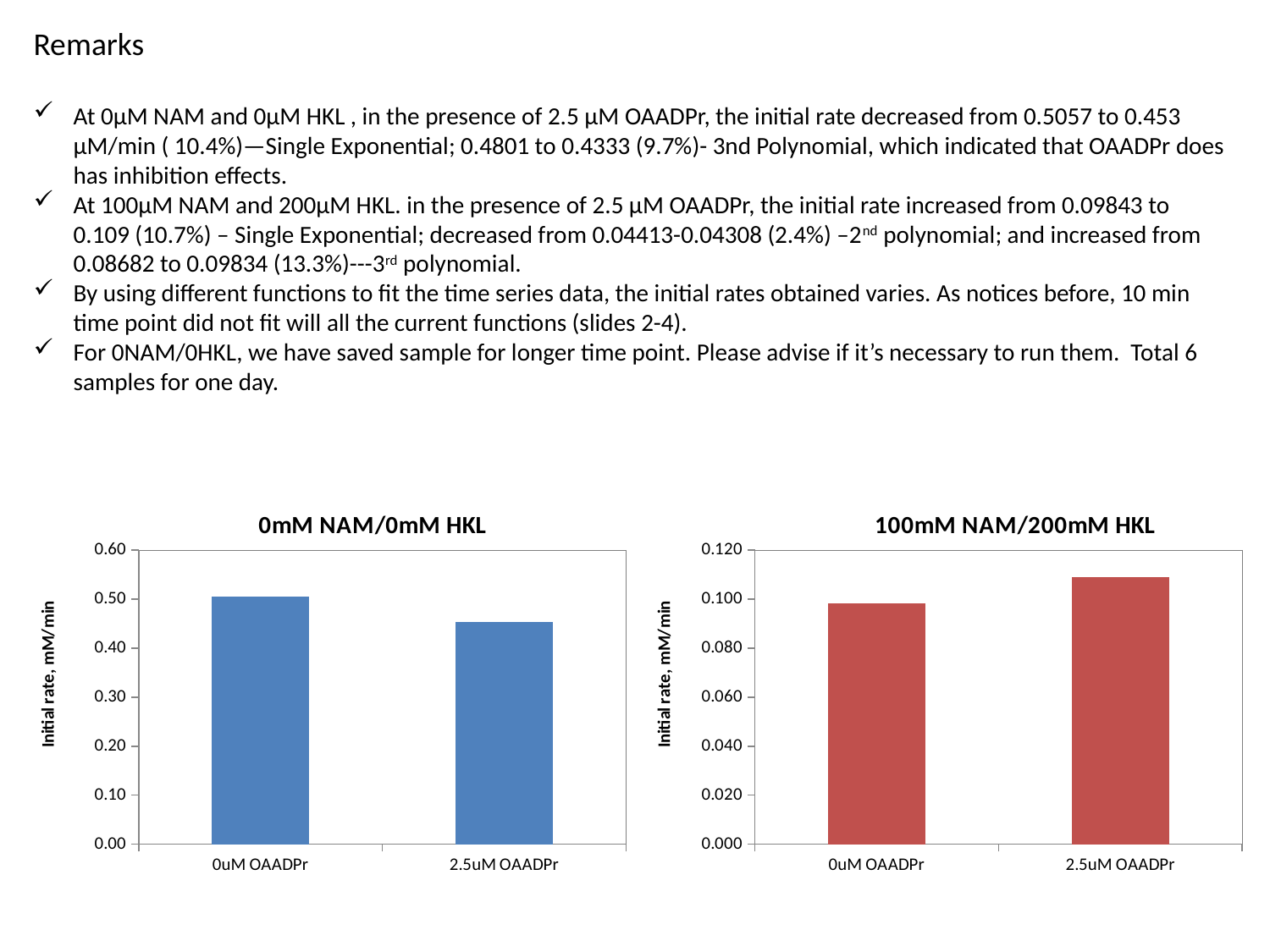
In the chart titled 0mM NAM/0mM HKL, is the value for 2.5uM OAADPr greater or less than 0.40? greater In the chart titled 100mM NAM/200mM HKL, is the value for 0uM OAADPr greater or less than 0.080? greater In the chart titled 100mM NAM/200mM HKL, which category has the higher initial rate? 2.5uM OAADPr In the chart titled 0mM NAM/0mM HKL, which category has the higher initial rate? 0uM OAADPr In the chart titled 0mM NAM/0mM HKL, do the values rise or fall from 0uM OAADPr to 2.5uM OAADPr? fall What is the y-axis label of the chart titled 0mM NAM/0mM HKL? Initial rate, mM/min In the chart titled 100mM NAM/200mM HKL, is the value for 2.5uM OAADPr greater or less than 0.100? greater In the chart titled 100mM NAM/200mM HKL, do the values rise or fall from 0uM OAADPr to 2.5uM OAADPr? rise In the chart titled 0mM NAM/0mM HKL, how many categories are shown on the x axis? 2 In the chart titled 0mM NAM/0mM HKL, which category has the lower initial rate? 2.5uM OAADPr What type of chart is the chart titled 100mM NAM/200mM HKL? bar chart